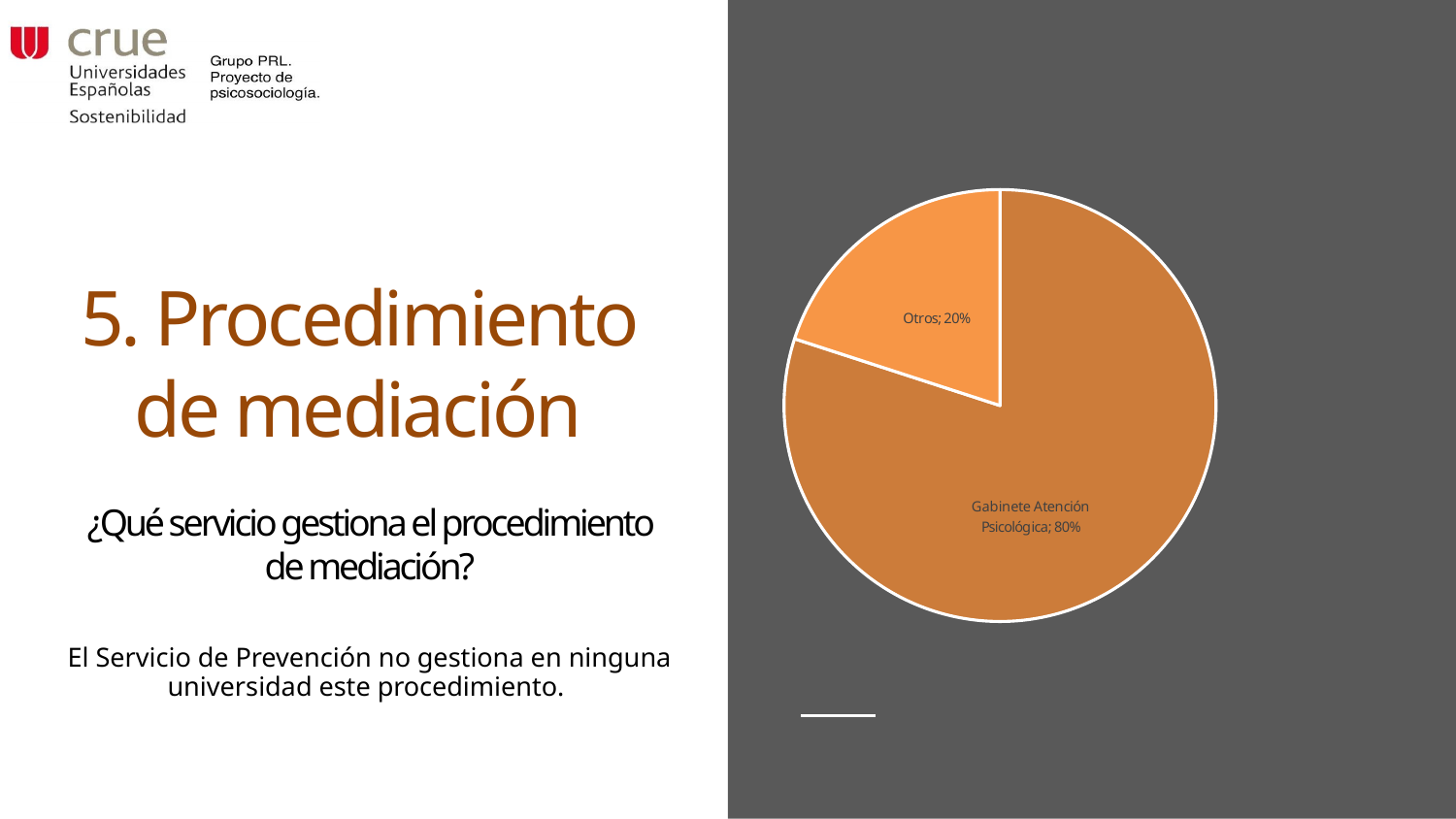
What is the difference in percentage points between Gabinete Atención Psicológica and Otros? 60 What share of the pie does Gabinete Atención Psicológica have? 80% Which slice of the pie is the largest? Gabinete Atención Psicológica Which slice of the pie is the smallest? Otros What question does the slide say the pie chart answers? ¿Qué servicio gestiona el procedimiento de mediación? Is the share for Gabinete Atención Psicológica greater or less than 50%? greater How many slices does the pie chart have? 2 What share of the pie does Otros have? 20% What kind of chart is shown on the slide? pie chart Which is larger, the share for Otros or the share for Gabinete Atención Psicológica? Gabinete Atención Psicológica What is the total of the two slices shown in the pie chart? 100%